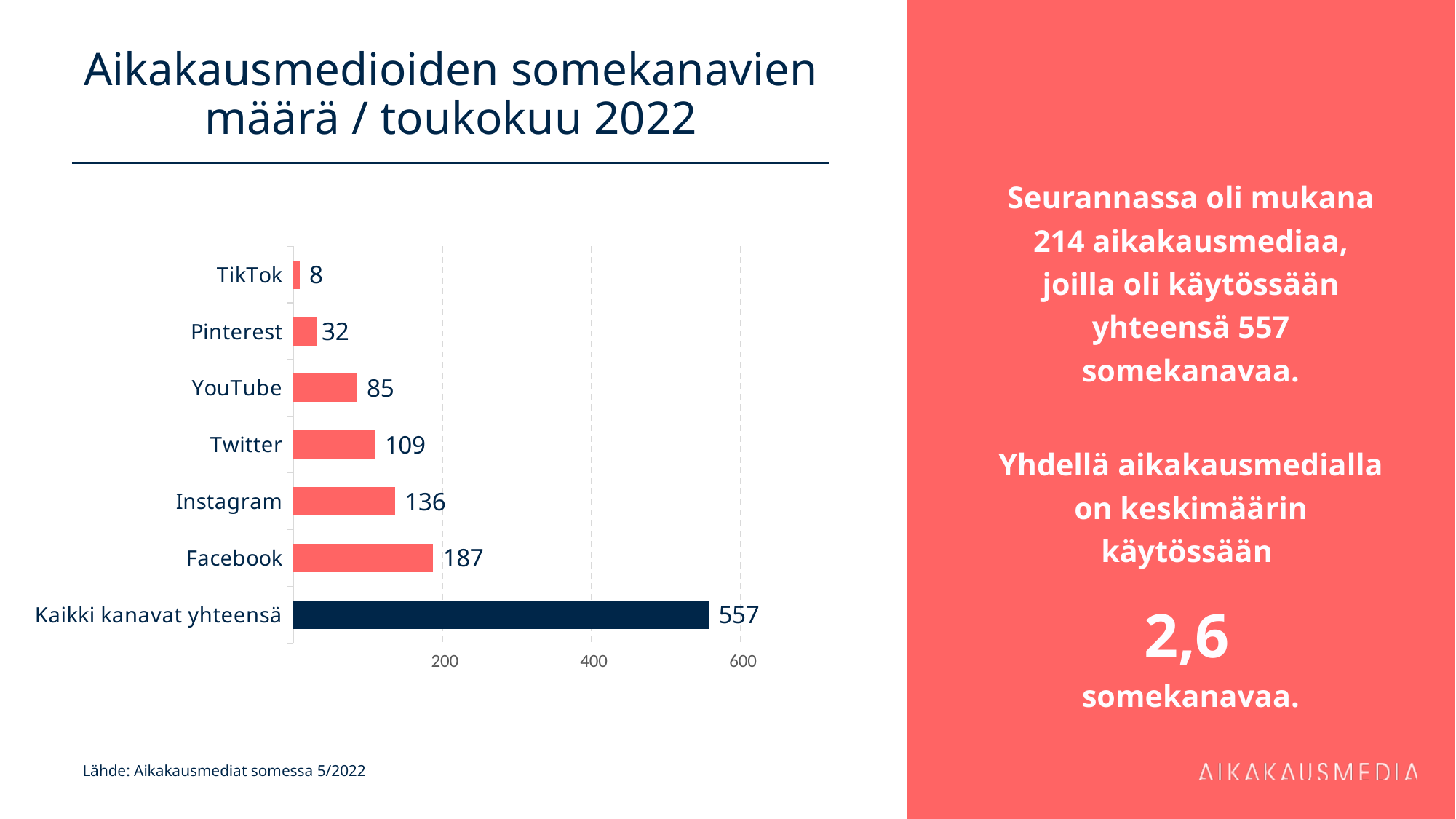
Which category has the lowest value? TikTok Which individual social media channel has the highest value? Facebook What is the difference between the values for Twitter and YouTube? 24 What is the difference between the values for Facebook and Instagram? 51 What is the title of the chart on the slide? Aikakausmedioiden somekanavien määrä / toukokuu 2022 Which is larger, the value for Pinterest or the value for YouTube? YouTube What is the value for TikTok? 8 What is the value for Instagram? 136 What is the value for Facebook? 187 What kind of chart is shown on the slide? Bar chart How many categories are shown in the chart? 7 What is the value shown for Kaikki kanavat yhteensä? 557